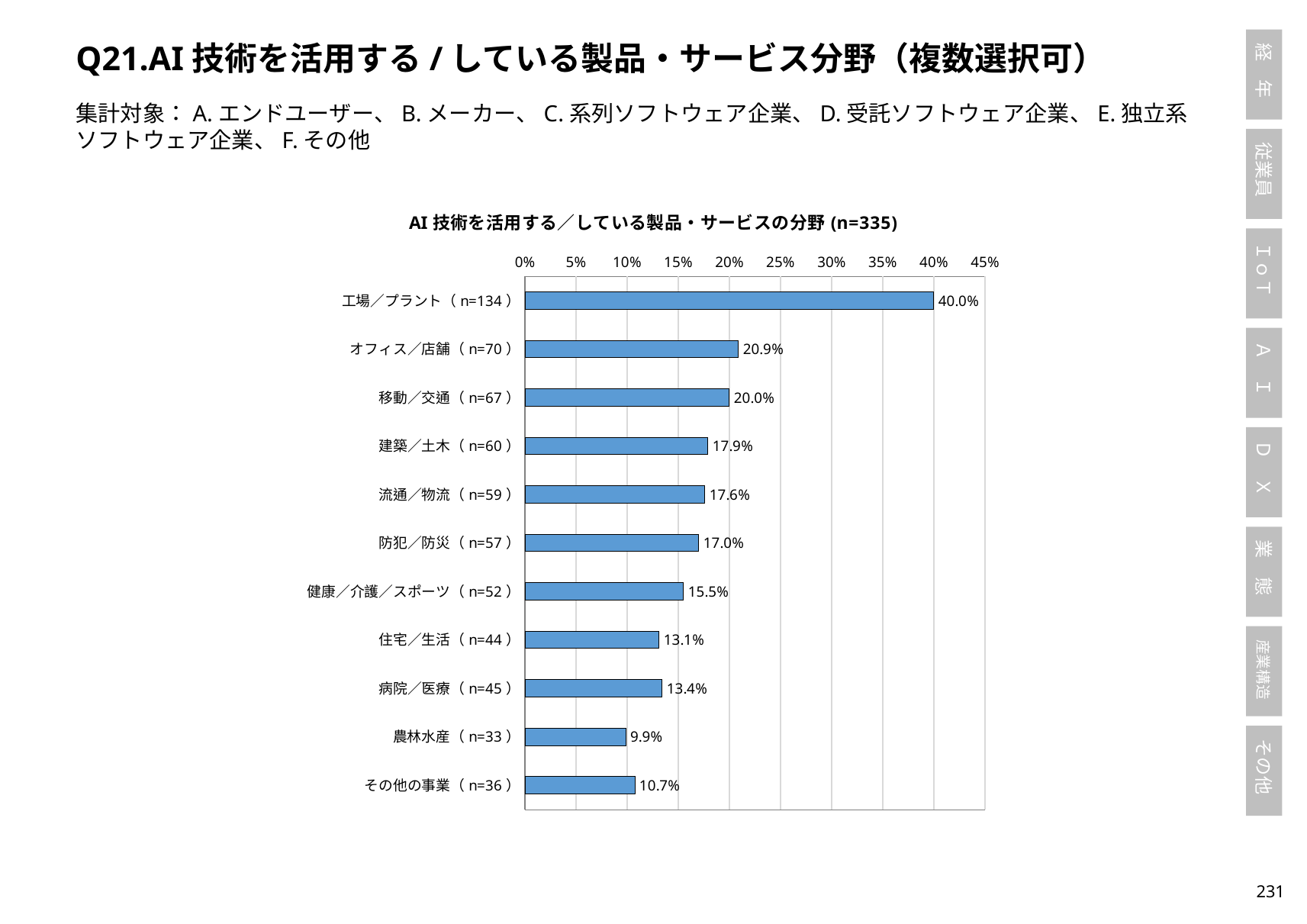
What is the difference between the values for 工場／プラント and オフィス／店舗? 19.1% Which category has the lowest value? 農林水産 (n=33) Which category has the highest value? 工場／プラント (n=134) What is the value for 農林水産 (n=33)? 9.9% What is the difference between the values for その他の事業 and 農林水産? 0.8% What is the title of the chart? AI 技術を活用する／している製品・サービスの分野 (n=335) Is the value for 建築／土木 greater or less than 15%? greater What kind of chart is shown on the slide? Bar chart Which is larger, the value for 住宅／生活 or the value for 病院／医療? 病院／医療 What is the value for 防犯／防災 (n=57)? 17.0% How many categories are shown in the chart? 11 What is the value for 工場／プラント (n=134)? 40.0%